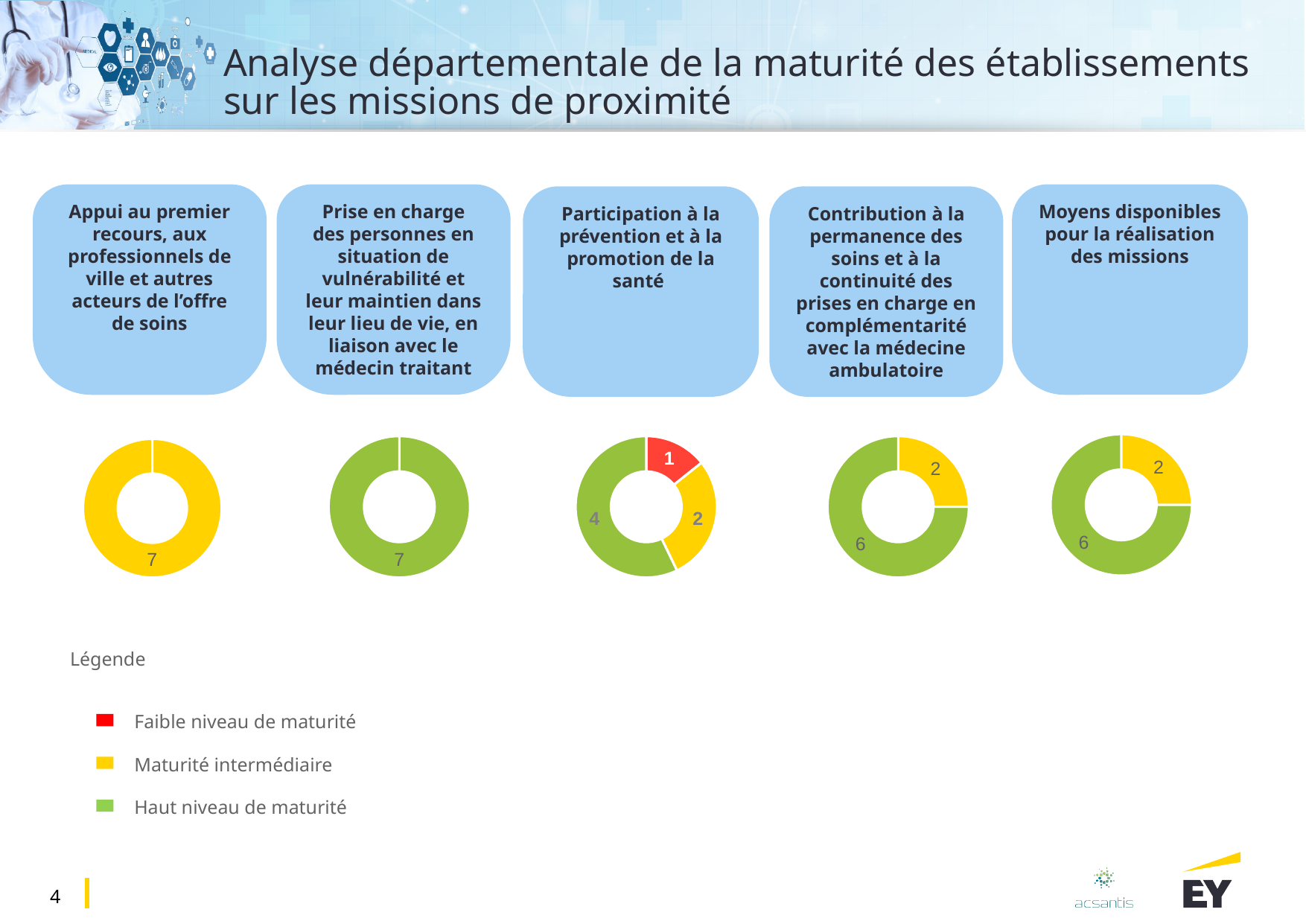
In the third chart from the left (Participation à la prévention et à la promotion de la santé), which maturity level has the largest slice? Haut niveau de maturité In the fourth chart from the left (Contribution à la permanence des soins), what is the value of the yellow 'Maturité intermédiaire' slice? 2 How many donut charts are shown on the slide? 5 In the third chart from the left (Participation à la prévention et à la promotion de la santé), what is the value of the green 'Haut niveau de maturité' slice? 4 In the leftmost chart (Appui au premier recours), what value is shown for the yellow 'Maturité intermédiaire' slice? 7 In the third chart from the left (Participation à la prévention et à la promotion de la santé), which maturity level has the smallest slice? Faible niveau de maturité In the third chart from the left (Participation à la prévention et à la promotion de la santé), what is the value of the red 'Faible niveau de maturité' slice? 1 What kind of chart is used under each mission heading on the slide? Donut chart In the third chart from the left (Participation à la prévention et à la promotion de la santé), what is the total of all slices? 7 How many maturity levels does the legend list? 3 In the fourth chart from the left (Contribution à la permanence des soins), what is the difference between the green slice and the yellow slice? 4 In the rightmost chart (Moyens disponibles pour la réalisation des missions), what is the value of the green 'Haut niveau de maturité' slice? 6